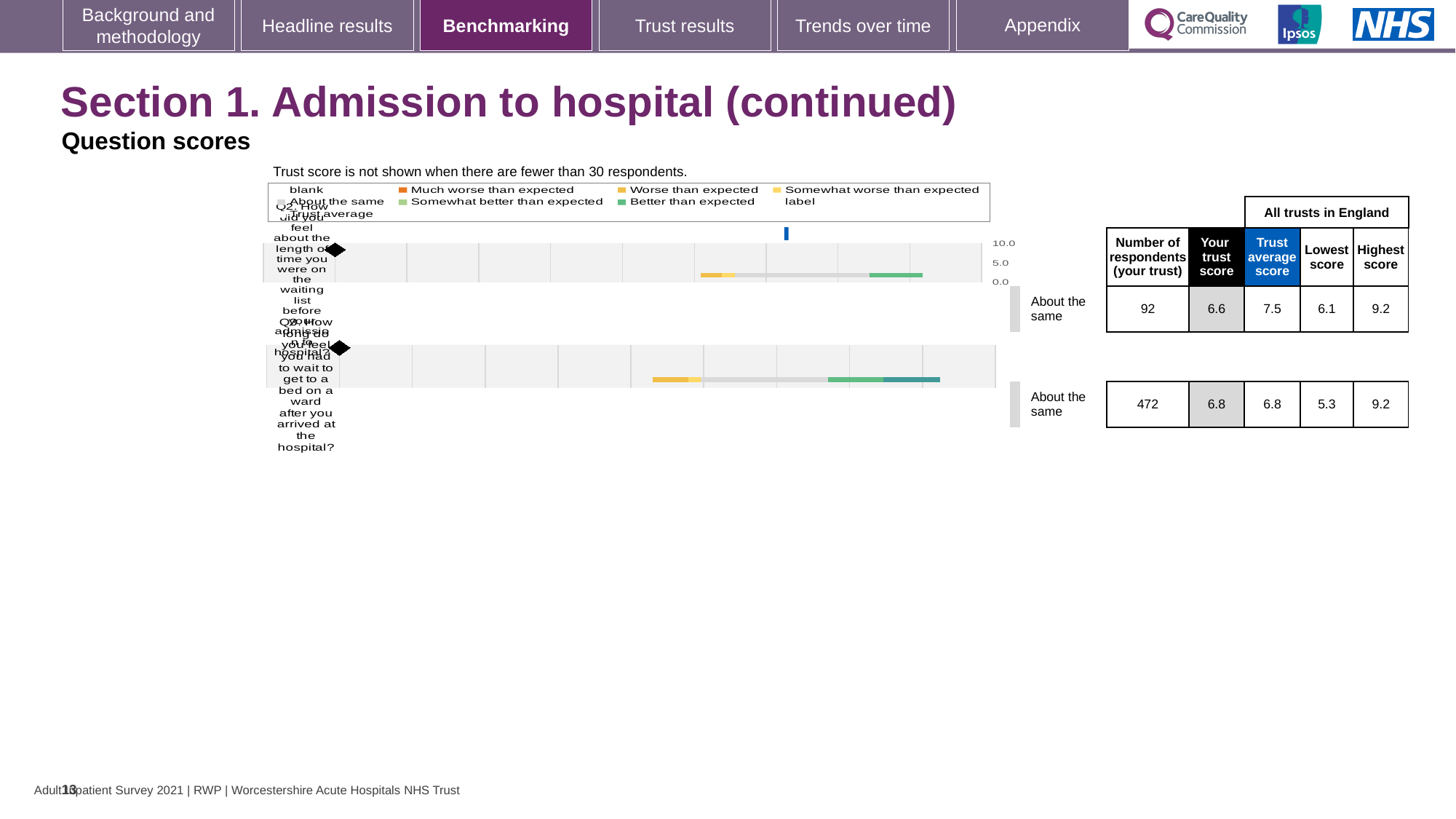
For Q2, which is larger: the trust's own score or the trust average score for all trusts in England? Trust average score What is the difference between the highest score and the lowest score for Q2? 3.1 How many questions are plotted on the chart? 2 What is the trust score for Q2 (how did you feel about the length of time on the waiting list before admission)? 6.6 According to the note above the chart, below how many respondents is the trust score not shown? 30 What is the lowest score among all trusts in England for Q3? 5.3 What is the difference between the trust average score and the lowest score for Q3? 1.5 How many respondents answered Q3 (how long did you feel you had to wait to get to a bed on a ward)? 472 What is the highest score among all trusts in England for Q2? 9.2 What kind of chart is used to show the question scores? Bar chart By how much does the trust average score exceed the trust's own score for Q2? 0.9 What is the trust average score across all trusts in England for Q2? 7.5